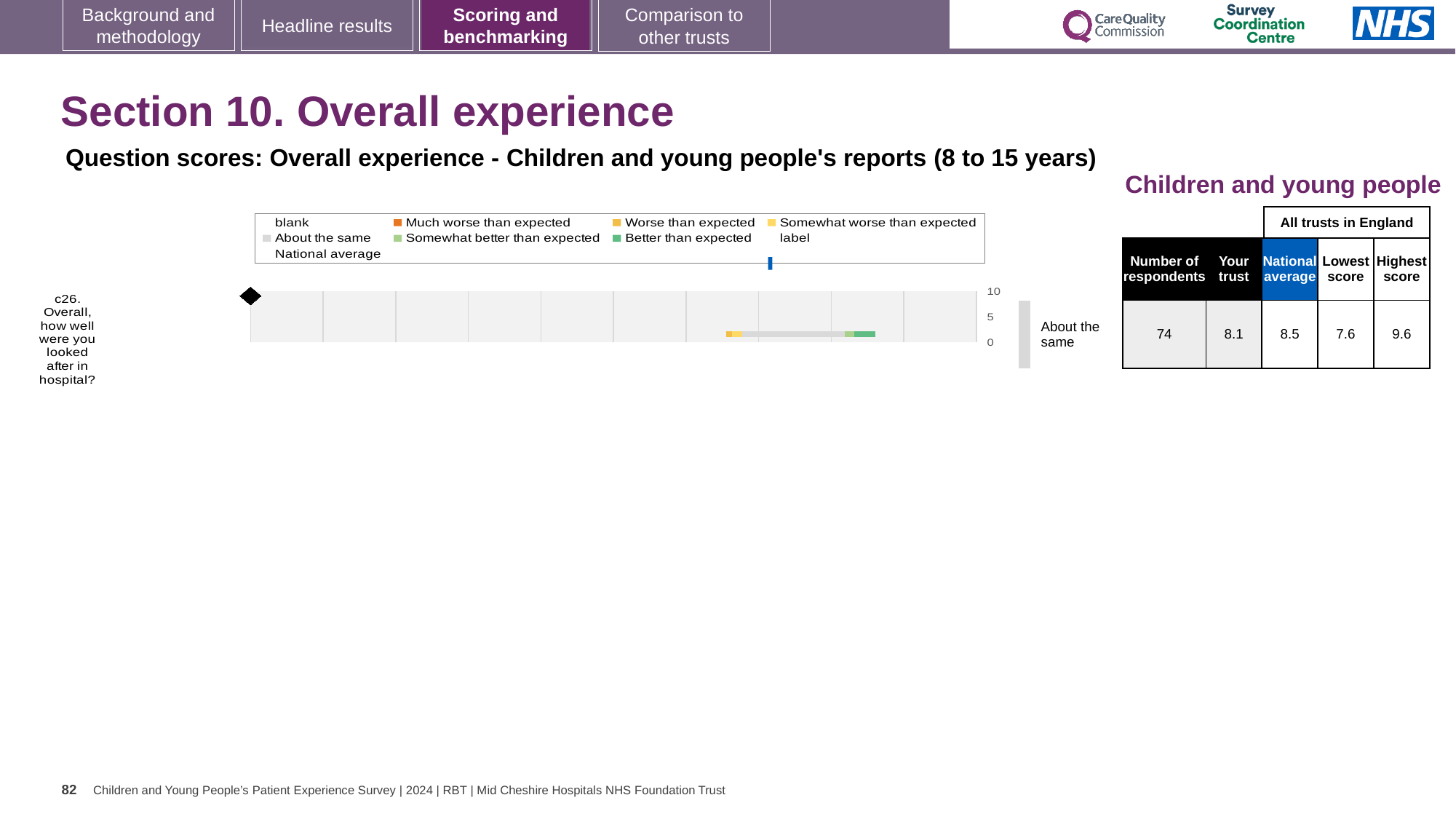
Which is larger for question c26: the 'Your trust' score or the national average? national average Is the 'Your trust' score for question c26 greater or less than 5? greater In the table beside the chart, what is the national average score for question c26? 8.5 In the table beside the chart, what is the 'Your trust' score for question c26? 8.1 What benchmark label is printed to the right of the bar for question c26? About the same In the table beside the chart, how many respondents answered question c26? 74 What is the highest tick value shown on the chart's axis? 10 How many question categories are plotted in the chart? 1 What is the label of the single category plotted in the chart? c26. Overall, how well were you looked after in hospital? What colour does the legend use for 'Better than expected'? green What kind of chart is shown on the slide? bar chart What is the difference between the highest score and the lowest score for question c26 in the table beside the chart? 2.0